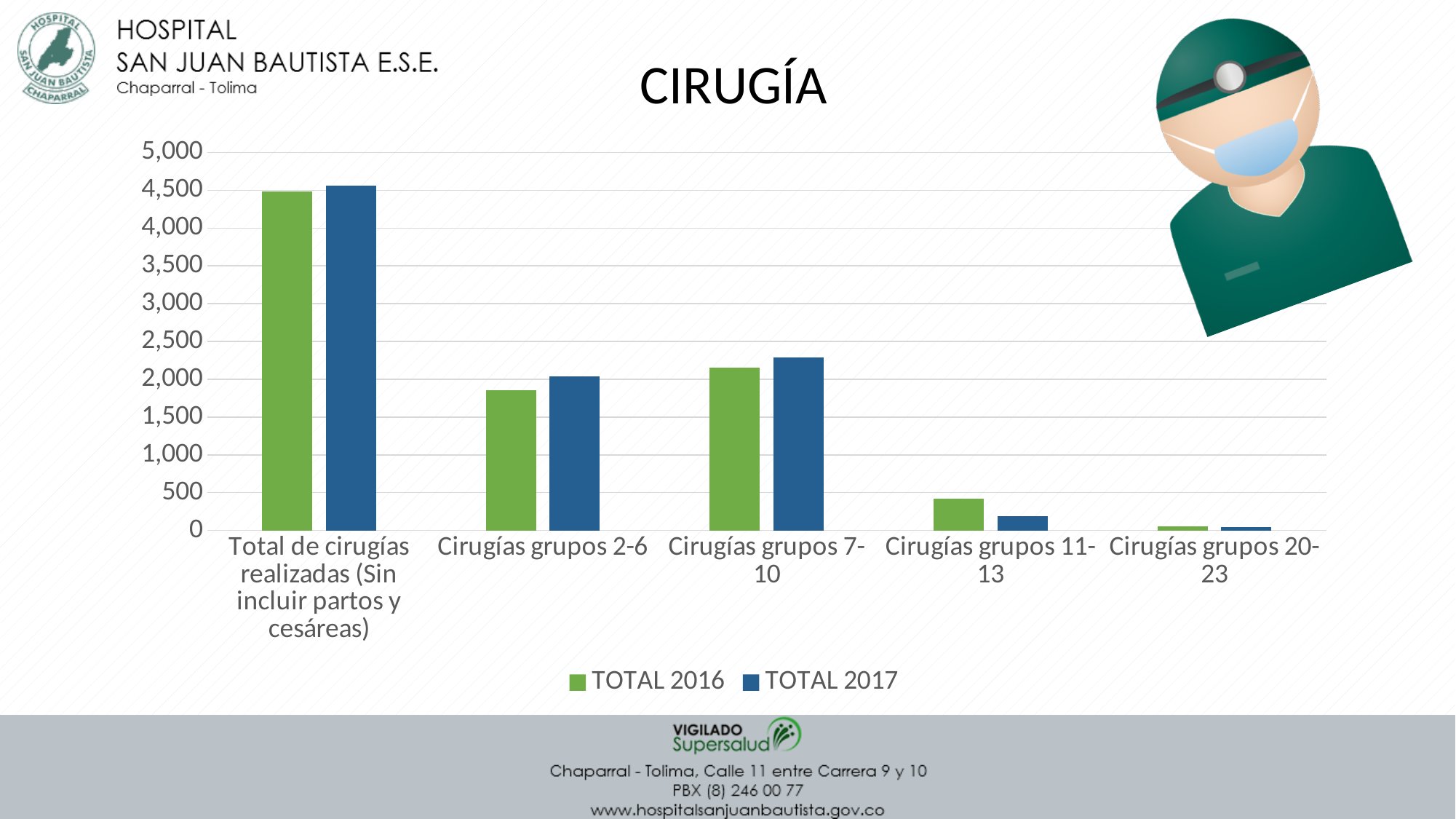
What type of chart is shown on the slide? bar chart Is the TOTAL 2016 value for Cirugías grupos 2-6 greater or less than 2,000? less Is the TOTAL 2017 value for Cirugías grupos 7-10 greater or less than 2,000? greater For Cirugías grupos 11-13, which is larger: TOTAL 2016 or TOTAL 2017? TOTAL 2016 What is the title of the chart? CIRUGÍA Which category has the lowest TOTAL 2016 value? Cirugías grupos 20-23 Which category has the highest TOTAL 2017 value? Total de cirugías realizadas (Sin incluir partos y cesáreas) Which series is shown in green in the chart? TOTAL 2016 Is the TOTAL 2016 value for Total de cirugías realizadas greater or less than 4,000? greater How many series does the chart legend list? 2 For Cirugías grupos 2-6, which is larger: TOTAL 2016 or TOTAL 2017? TOTAL 2017 How many categories are shown on the x axis of the chart? 5